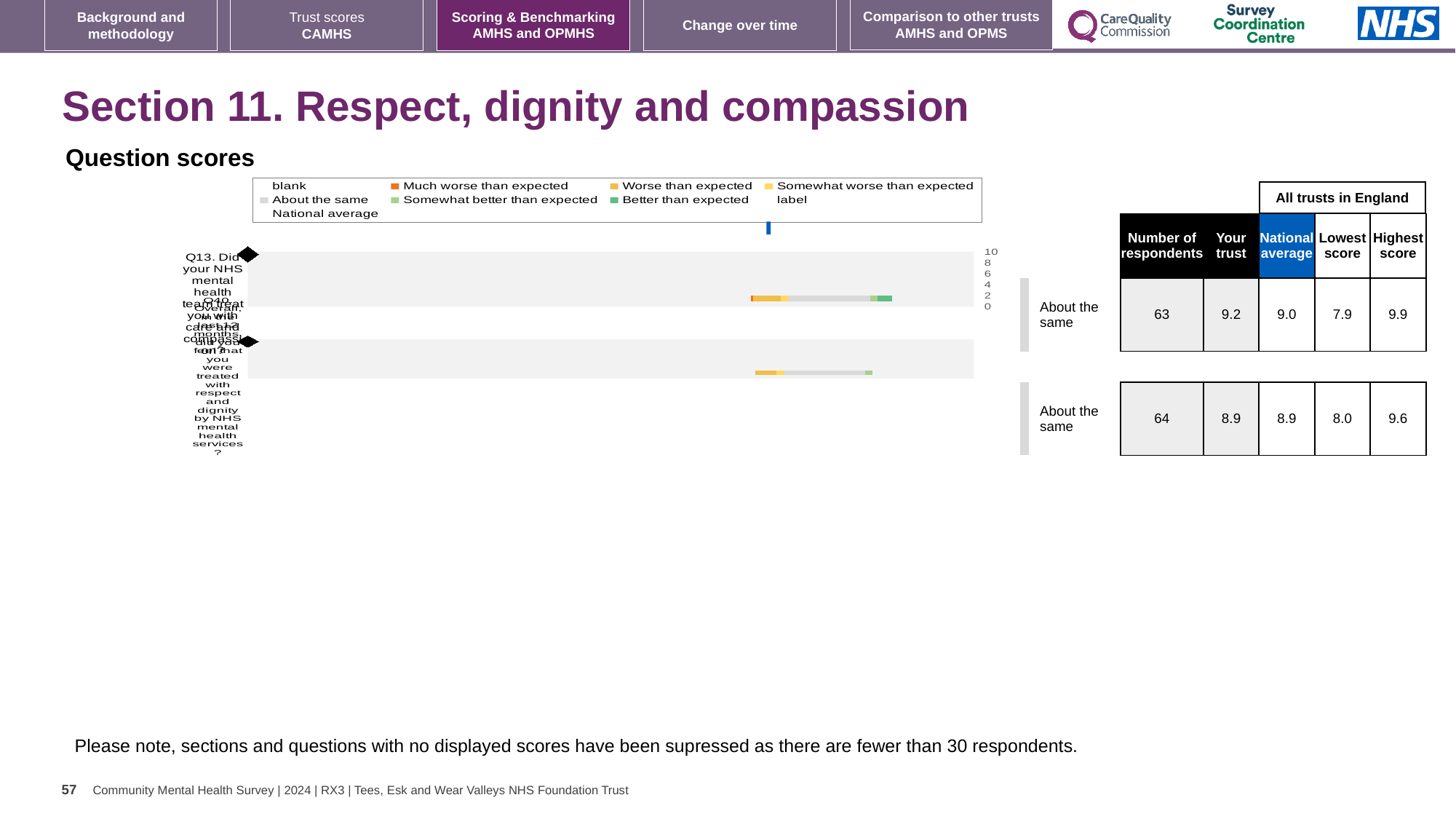
How many entries does the legend of the question scores chart list? 9 What is the 'Your trust' score for the top row (Q13) in the table beside the chart? 9.2 What is the lowest score among all trusts in England for the bottom row (Q10)? 8.0 What is the maximum value shown on the chart's axis? 10 For the top row (Q13), which is larger: the 'Your trust' score or the national average? Your trust What is the difference between the highest score and the lowest score for the top row (Q13)? 2.0 How many questions (rows) are plotted in the question scores chart? 2 What benchmark category is shown next to both rows of the chart? About the same What kind of chart is used to show the question scores? bar chart What is the national average score for the bottom row (Q10)? 8.9 Which row has more respondents, the top row (Q13) or the bottom row (Q10)? Q10 (bottom row) How many respondents are shown for the top row (Q13)? 63